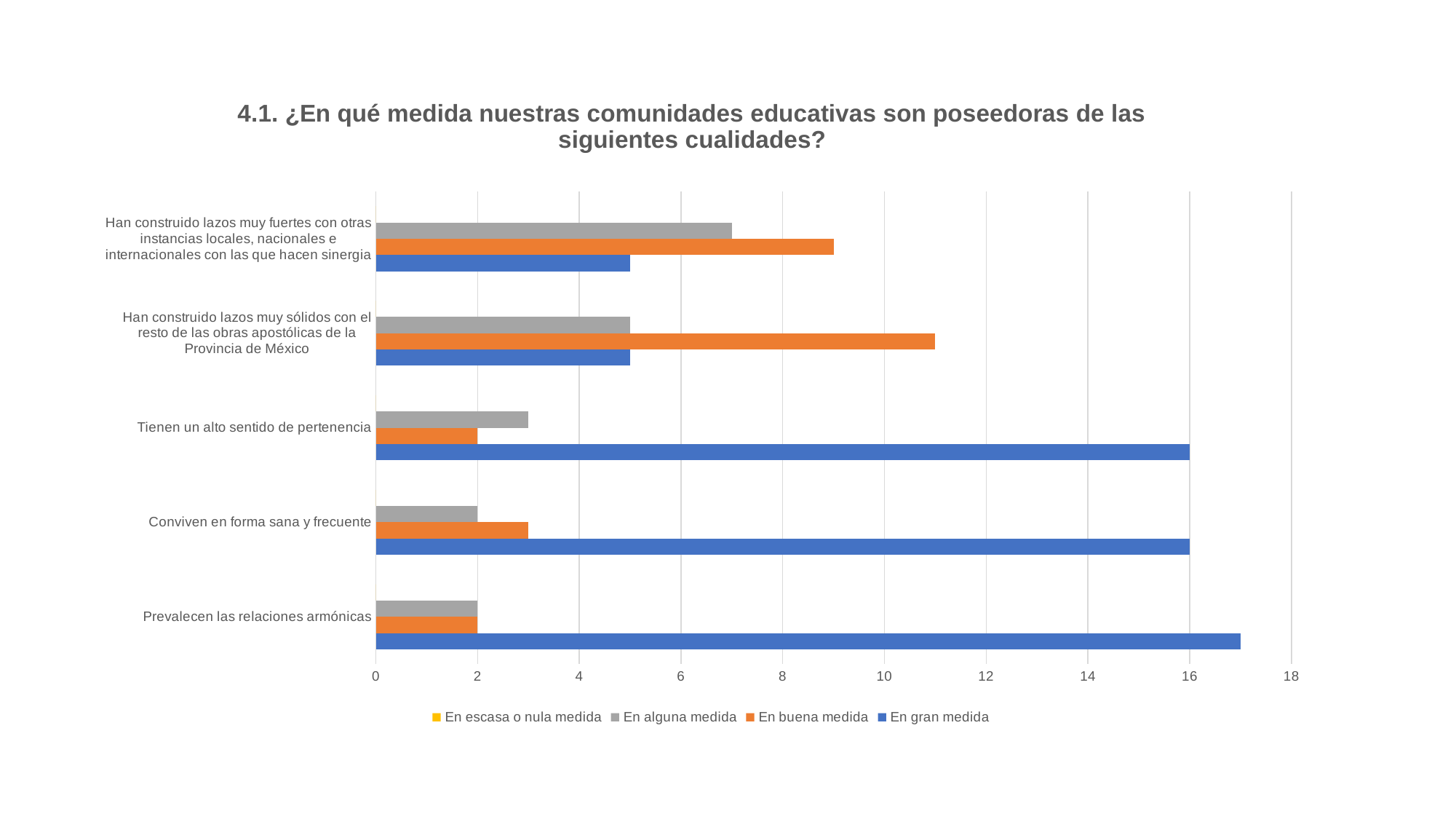
How many series does the legend list? 4 What kind of chart is shown on the slide? bar chart What is the value of 'En gran medida' for 'Conviven en forma sana y frecuente'? 16 Is the value of 'En gran medida' for 'Han construido lazos muy fuertes con otras instancias locales, nacionales e internacionales con las que hacen sinergia' greater or less than 6? less Which series is shown in blue in the legend? En gran medida What is the value of 'En gran medida' for 'Tienen un alto sentido de pertenencia'? 16 For 'Han construido lazos muy fuertes con otras instancias locales, nacionales e internacionales con las que hacen sinergia', which is larger: 'En alguna medida' or 'En buena medida'? En buena medida Which category has the highest value for 'En buena medida'? Han construido lazos muy sólidos con el resto de las obras apostólicas de la Provincia de México What is the value of 'En buena medida' for 'Tienen un alto sentido de pertenencia'? 2 Is the value of 'En buena medida' for 'Han construido lazos muy sólidos con el resto de las obras apostólicas de la Provincia de México' greater or less than 10? greater How many categories are plotted on the chart? 5 What is the value of 'En alguna medida' for 'Prevalecen las relaciones armónicas'? 2